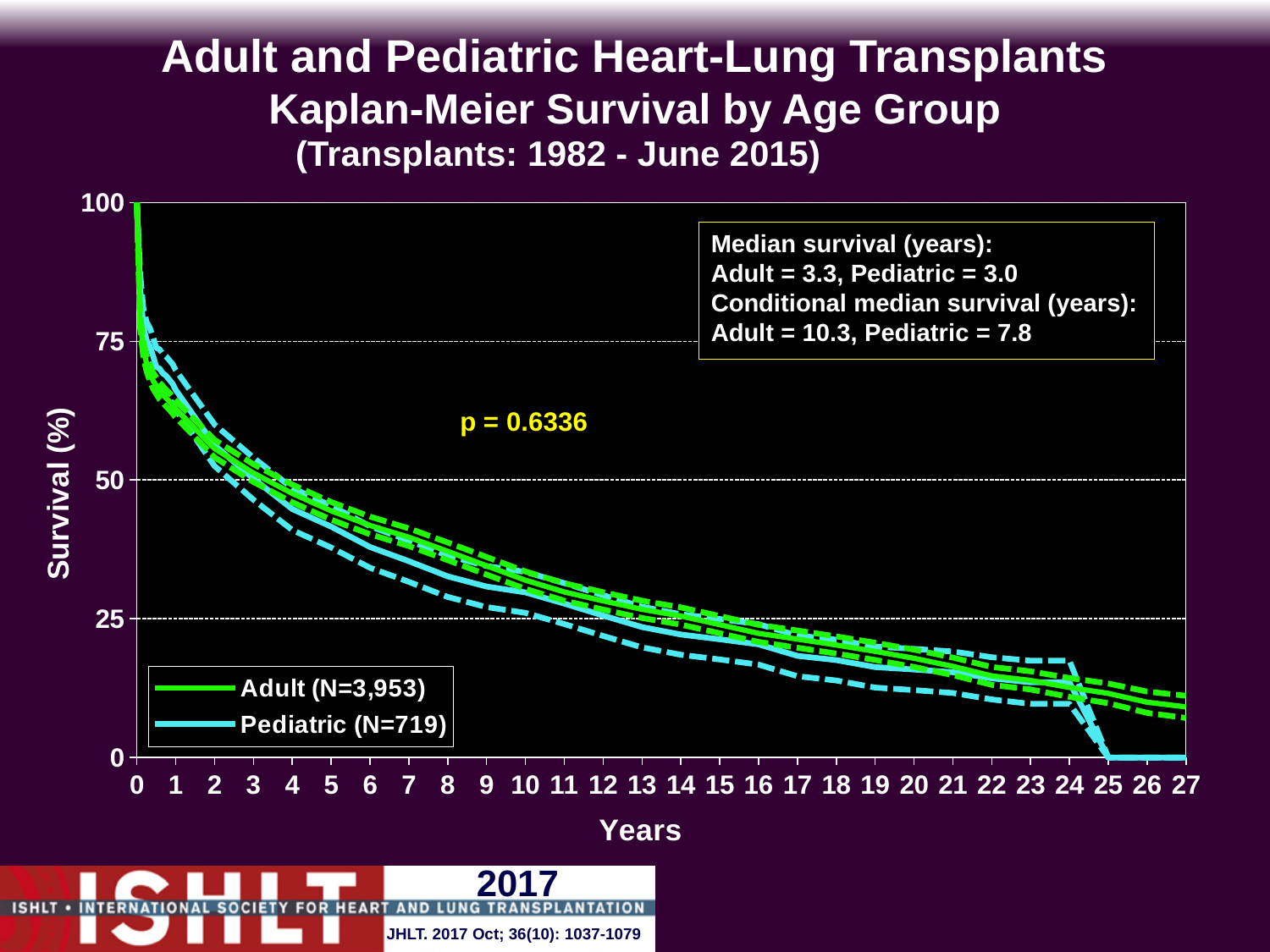
What is the difference between the Adult and Pediatric conditional median survival in years? 2.5 How many series does the legend list? 2 Do the survival curves rise or fall as years increase? Fall What is the median survival in years for the Pediatric group? 3.0 Is the Adult survival at 10 years greater or less than 25? greater What is the N for the Pediatric group in the legend? 719 What is the conditional median survival in years for the Adult group? 10.3 Is the Adult survival at 20 years greater or less than 25? less What is the median survival in years for the Adult group? 3.3 Which group has the higher median survival, Adult or Pediatric? Adult What is the p-value shown on the chart? p = 0.6336 What kind of chart is shown on the slide? Line chart